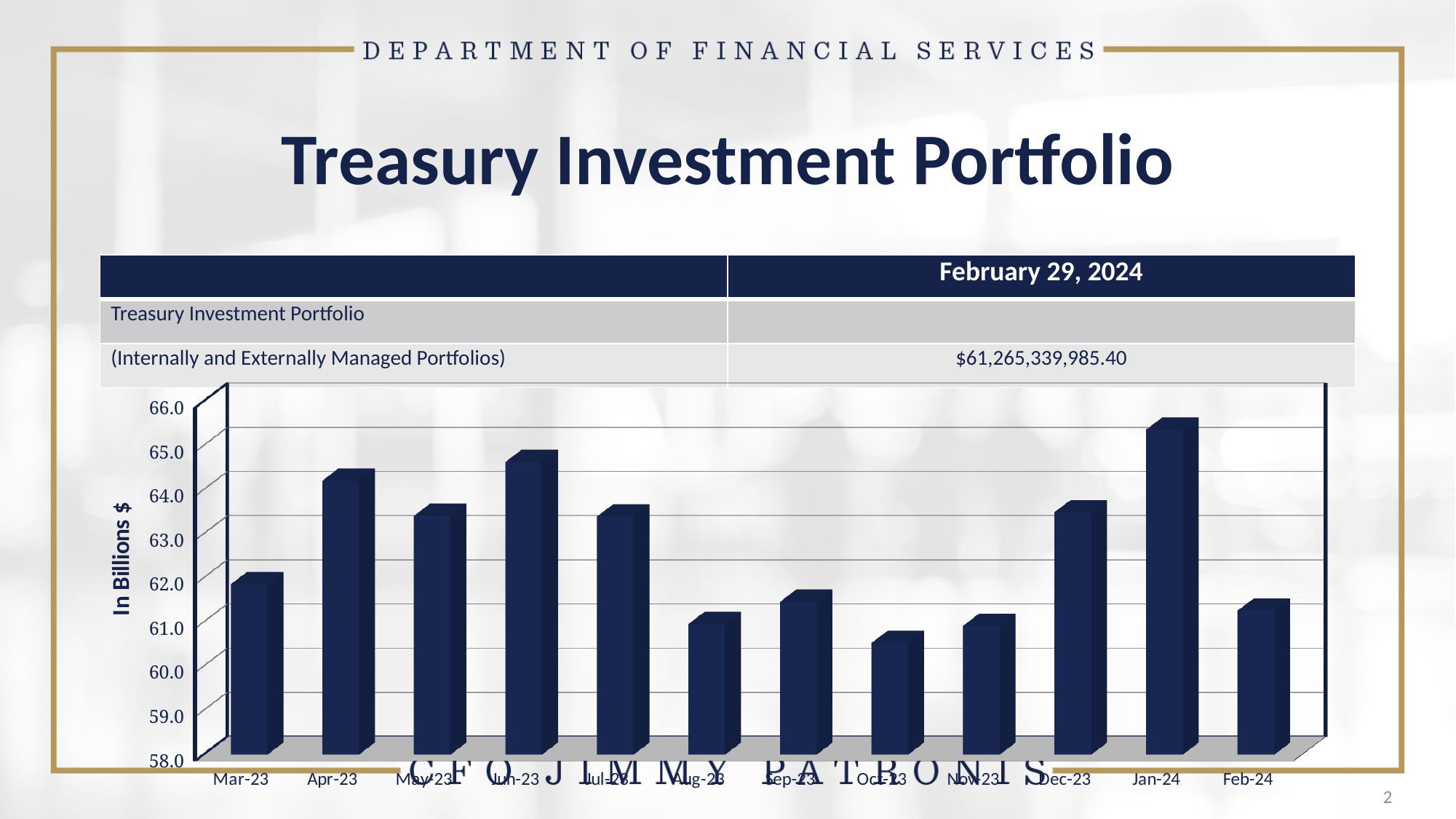
Which month has the lowest value on the chart? Oct-23 What is the label on the vertical axis of the chart? In Billions $ What kind of chart is shown on the slide? bar chart Which is larger, the value for Apr-23 or the value for May-23? Apr-23 Is the value for Jun-23 greater or less than 64.0? greater Is the value for Feb-24 greater or less than 62.0? less Do the values rise or fall from Jun-23 to Oct-23? fall Which month has the highest value on the chart? Jan-24 Is the value for Jan-24 greater or less than 65.0? greater How many months are plotted on the chart? 12 Which is larger, the value for Dec-23 or the value for Jan-24? Jan-24